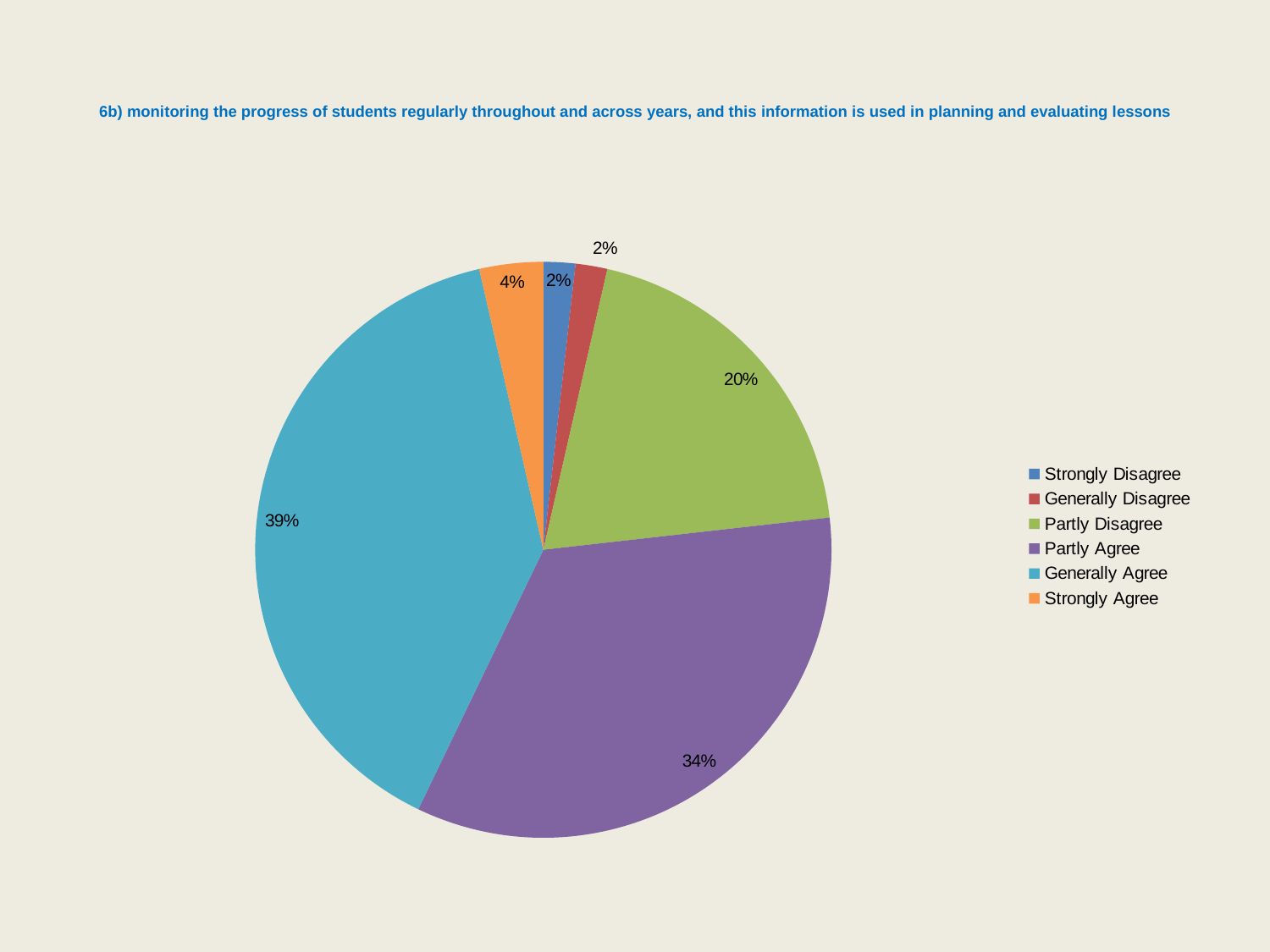
What share of the pie does Strongly Disagree represent? 2% What share of the pie does Generally Agree represent? 39% How many categories does the legend list? 6 What share of the pie does Partly Agree represent? 34% Which is larger, the share for Partly Disagree or the share for Strongly Agree? Partly Disagree Which colour represents Partly Agree in the pie chart? purple What is the combined share of Partly Agree and Generally Agree? 73% What type of chart is shown on the slide? pie chart What is the difference in percentage points between Generally Agree and Partly Agree? 5% Which category has the largest slice of the pie? Generally Agree